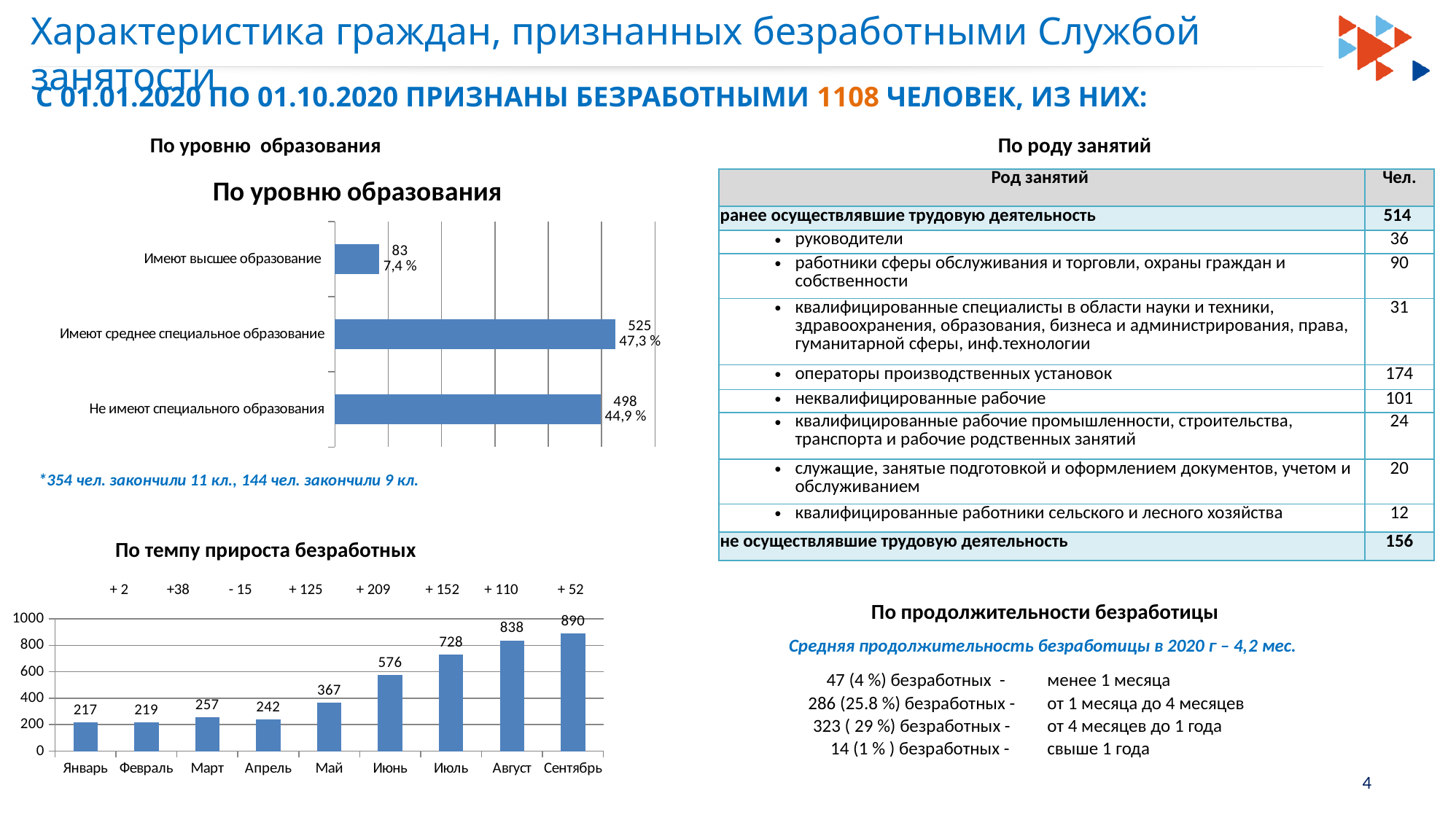
In the chart 'По темпу прироста безработных', which month has the lowest value? Январь In the chart 'По уровню образования', which category has the lowest value? Имеют высшее образование In the chart 'По уровню образования', what percentage is shown for 'Имеют среднее специальное образование'? 47,3 % In the chart 'По уровню образования', how many categories are shown? 3 In the chart 'По уровню образования', what is the value for 'Имеют высшее образование'? 83 In the chart 'По уровню образования', what is the difference between the values for 'Имеют среднее специальное образование' and 'Не имеют специального образования'? 27 What kind of chart is 'По темпу прироста безработных'? Bar chart In the chart 'По уровню образования', which category has the highest value? Имеют среднее специальное образование In the chart 'По темпу прироста безработных', which month has the highest value? Сентябрь In the chart 'По темпу прироста безработных', which is larger: the value for Март or the value for Апрель? Март In the chart 'По темпу прироста безработных', what is the value for Июнь? 576 In the chart 'По темпу прироста безработных', what is the difference between the values for Август and Июль? 110